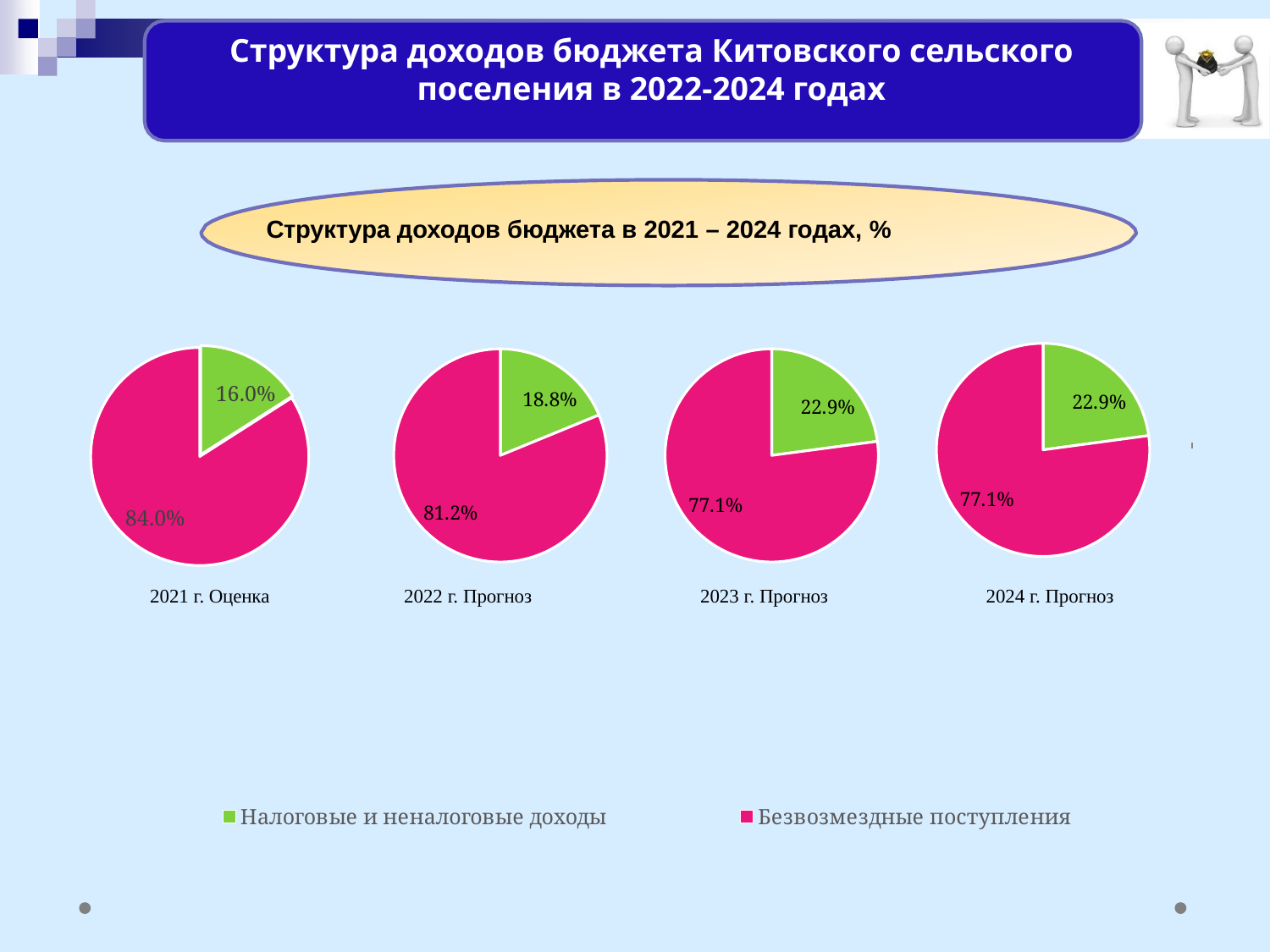
In the pie chart labelled "2021 г. Оценка", what is the difference between the share of Безвозмездные поступления and the share of Налоговые и неналоговые доходы? 68.0% Which colour represents Безвозмездные поступления in the legend? Pink (magenta) Which is larger: the share of Налоговые и неналоговые доходы in the "2021 г. Оценка" chart or in the "2022 г. Прогноз" chart? 2022 г. Прогноз In the pie chart labelled "2022 г. Прогноз", which slice is the smallest? Налоговые и неналоговые доходы What kind of chart is used to show the budget income structure for each year? Pie chart In the pie chart labelled "2023 г. Прогноз", what share is shown for Налоговые и неналоговые доходы? 22.9% How many pie charts are shown on the slide? 4 In the pie chart labelled "2021 г. Оценка", which slice is the largest? Безвозмездные поступления In the pie chart labelled "2021 г. Оценка", what share is shown for Налоговые и неналоговые доходы? 16.0% How many series does the legend list? 2 In the pie chart labelled "2022 г. Прогноз", what share is shown for Безвозмездные поступления? 81.2% In the pie chart labelled "2024 г. Прогноз", what share is shown for Безвозмездные поступления? 77.1%